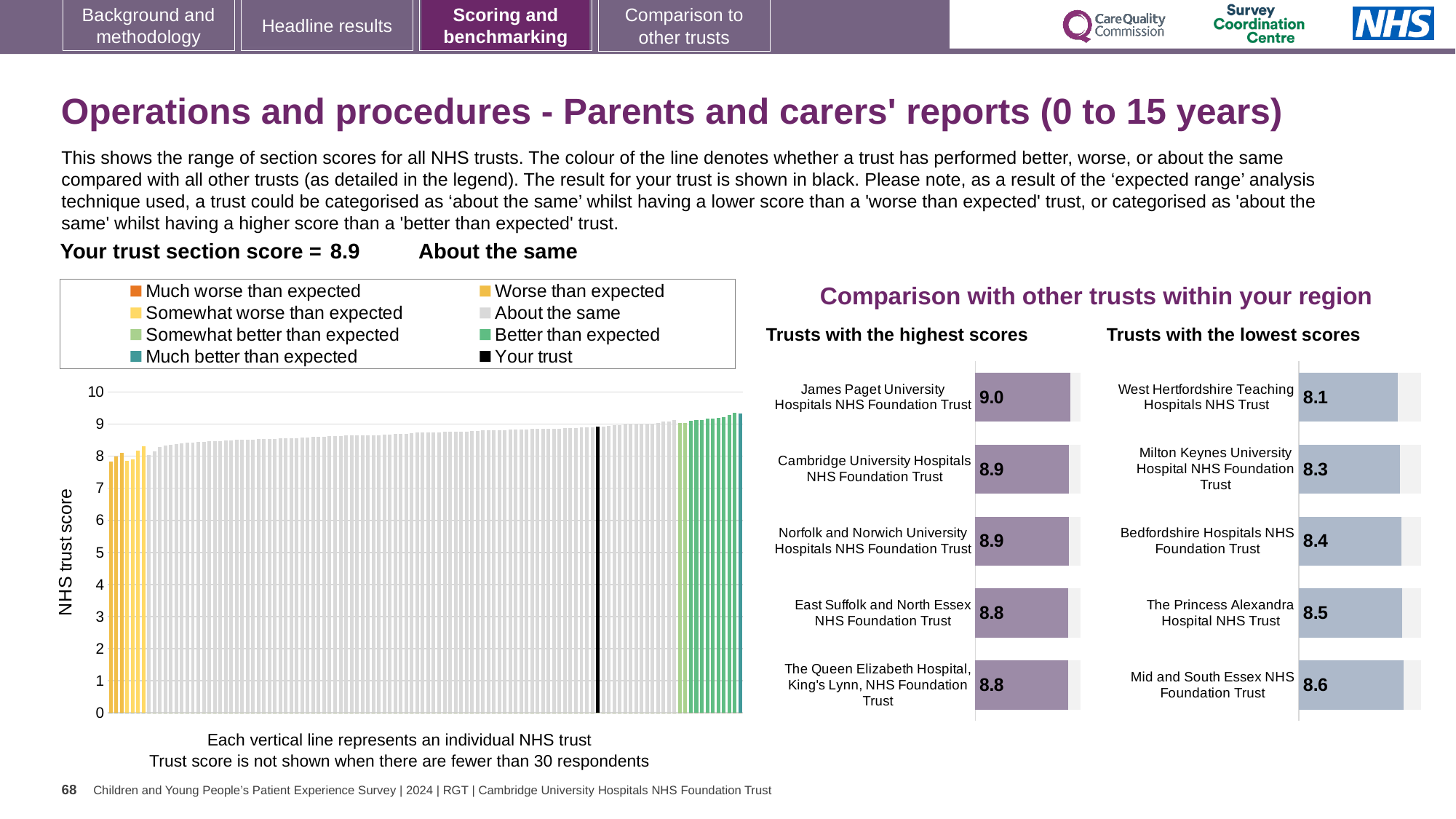
How many trusts are listed in the 'Trusts with the highest scores' chart? 5 In the main 'NHS trust score' chart, is the value for the black 'Your trust' bar greater or less than 8? greater In the 'Trusts with the lowest scores' chart, what is the difference between the scores of Mid and South Essex NHS Foundation Trust and West Hertfordshire Teaching Hospitals NHS Trust? 0.5 In the 'Trusts with the lowest scores' chart, which trust has the lowest score? West Hertfordshire Teaching Hospitals NHS Trust In the 'Trusts with the highest scores' chart, what is the difference between the scores of James Paget University Hospitals NHS Foundation Trust and East Suffolk and North Essex NHS Foundation Trust? 0.2 In the 'Trusts with the lowest scores' chart, which has the larger score: Bedfordshire Hospitals NHS Foundation Trust or Milton Keynes University Hospital NHS Foundation Trust? Bedfordshire Hospitals NHS Foundation Trust In the main 'NHS trust score' chart, do the bar values rise or fall from left to right? Rise What kind of chart is the main chart on the left with the 'NHS trust score' axis? Bar chart In the 'Trusts with the highest scores' chart, which trust has the highest score? James Paget University Hospitals NHS Foundation Trust How many entries does the legend of the main 'NHS trust score' chart list? 8 In the 'Trusts with the highest scores' chart, what is the score for James Paget University Hospitals NHS Foundation Trust? 9.0 In the 'Trusts with the lowest scores' chart, what is the score for Milton Keynes University Hospital NHS Foundation Trust? 8.3